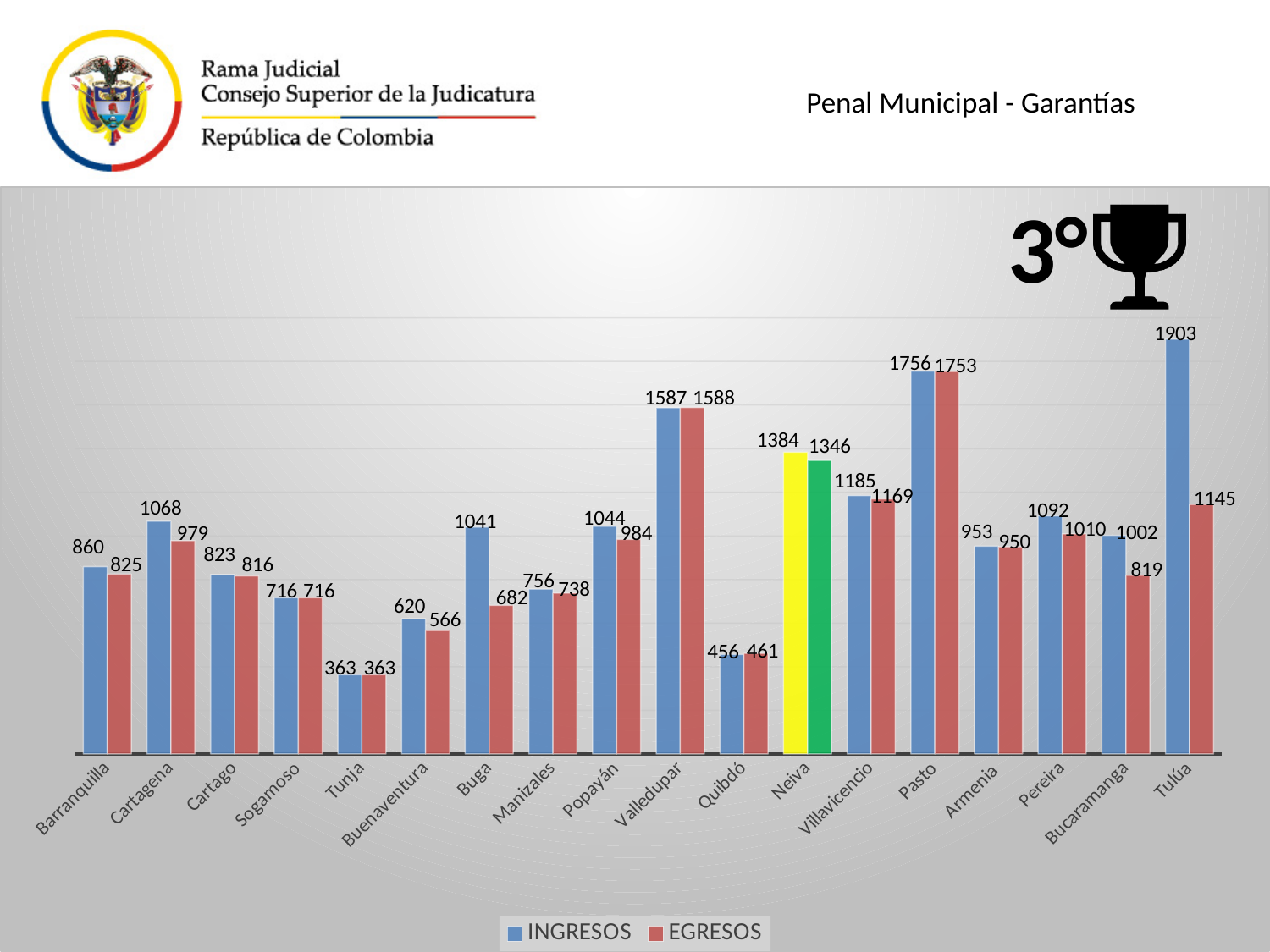
Which is larger, the INGRESOS value for Cartagena or the INGRESOS value for Pereira? Pereira Which city has the highest INGRESOS value? Tulúa How many cities are shown on the x axis? 18 What is the difference between INGRESOS and EGRESOS for Tulúa? 758 What is the INGRESOS value for Neiva? 1384 What is the EGRESOS value for Bucaramanga? 819 What is the difference between INGRESOS and EGRESOS for Buga? 359 What is the EGRESOS value for Valledupar? 1588 What type of chart is shown on the slide? Bar chart How many series does the legend list? 2 Which city has the highest EGRESOS value? Pasto Which city has the lowest EGRESOS value? Tunja